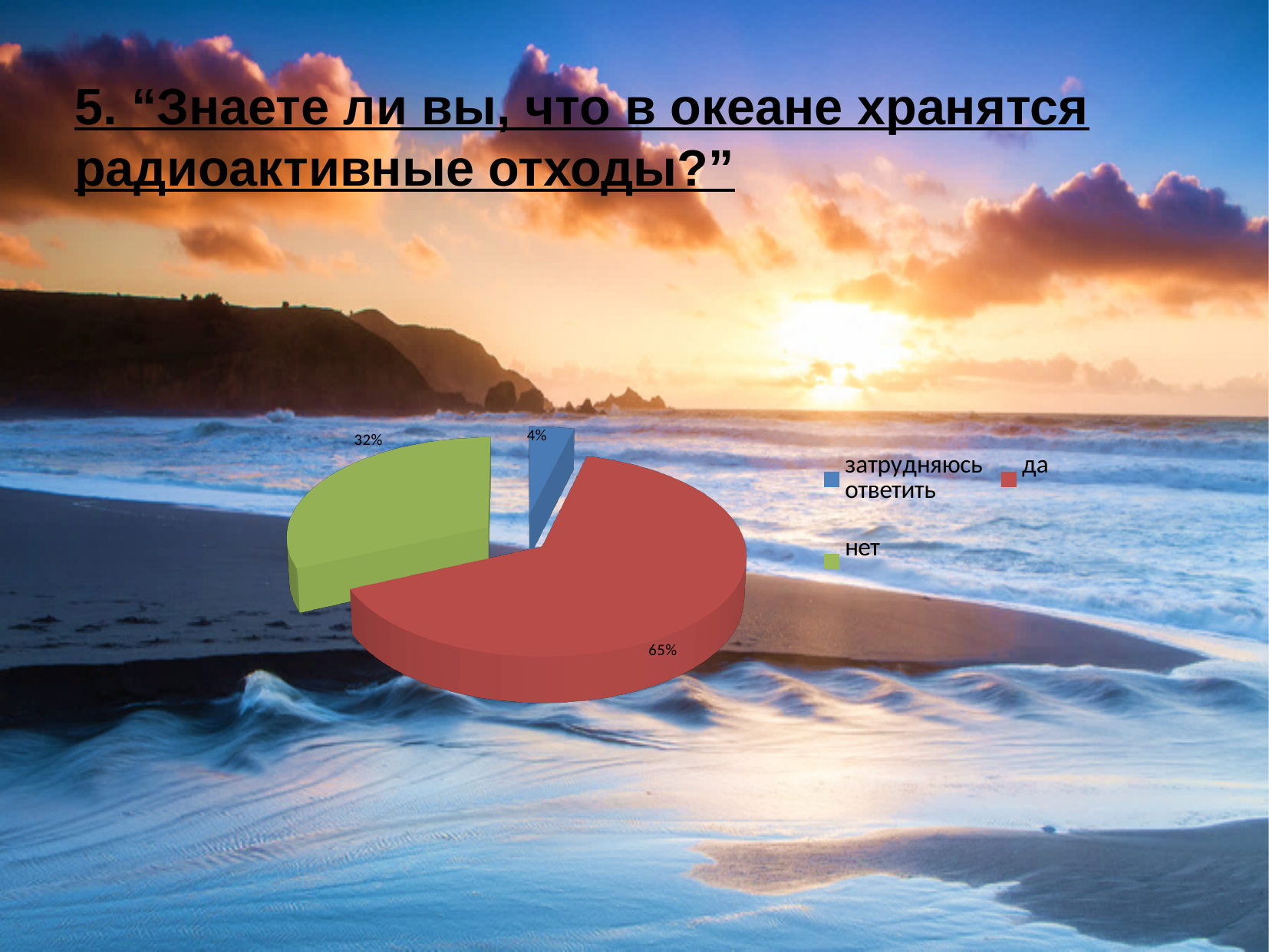
Which is larger, the share for "нет" or the share for "затрудняюсь ответить"? нет What percentage of respondents answered "затрудняюсь ответить"? 4% What kind of chart is shown on the slide? pie chart What percentage of respondents answered "да"? 65% Which answer has the largest share of the pie? да What colour is the slice for "нет"? green How many slices does the pie chart have? 3 Which answer has the smallest share of the pie? затрудняюсь ответить What is the difference in percentage points between "нет" and "затрудняюсь ответить"? 28 How many entries does the legend list? 3 What percentage of respondents answered "нет"? 32% What is the difference in percentage points between "да" and "нет"? 33